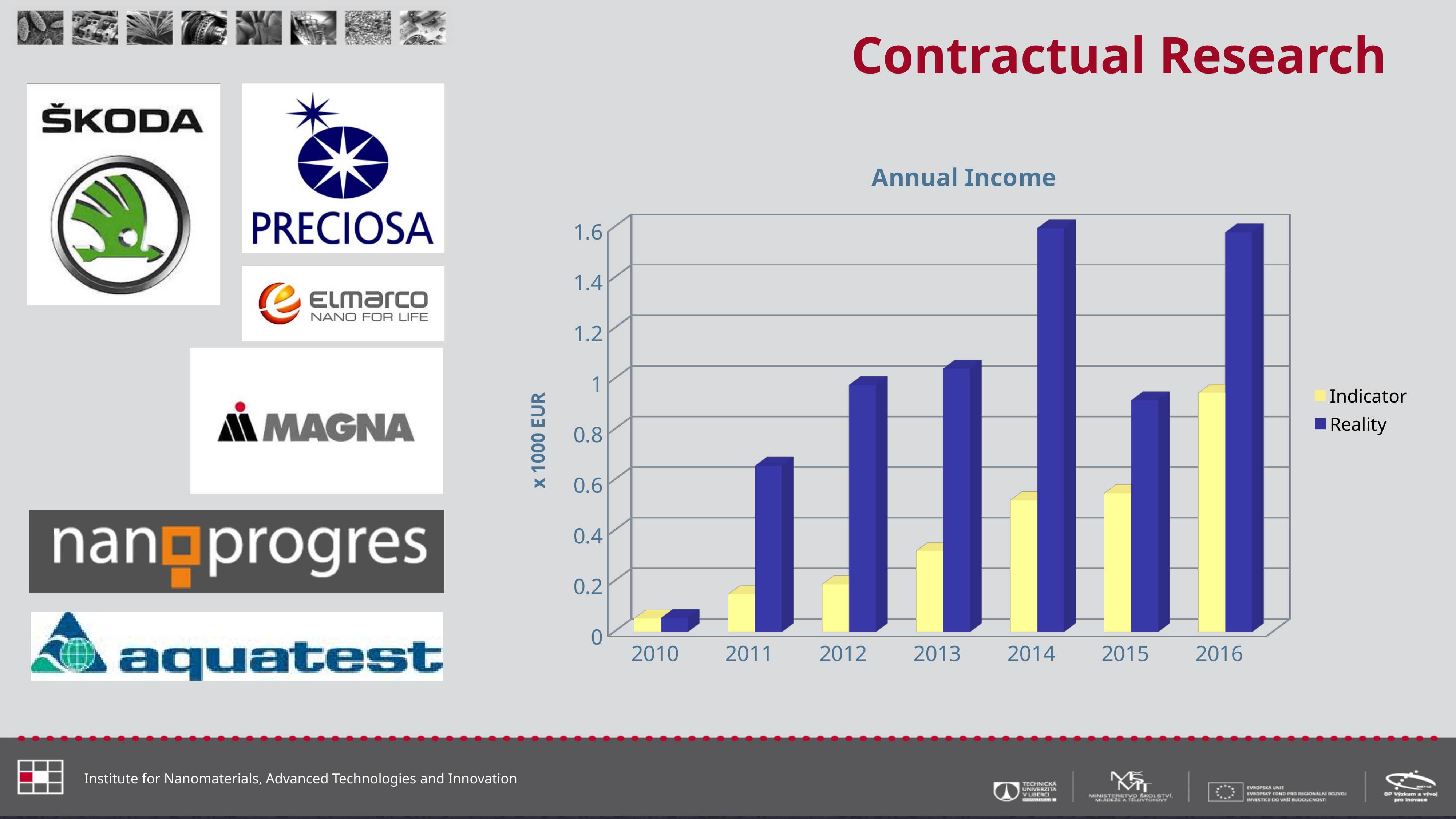
Is the Indicator value for 2013 greater or less than 0.6? less Does the Indicator series rise or fall from 2010 to 2016? rise What is the y-axis label of the Annual Income chart? x 1000 EUR How many series does the legend of the Annual Income chart list? 2 What type of chart is shown under the title "Annual Income"? bar chart How many years are shown on the x axis of the Annual Income chart? 7 In which year is the Reality value lowest in the Annual Income chart? 2010 Is the Reality value for 2011 greater or less than 0.4? greater Which colour represents the Reality series in the Annual Income chart? blue In which year is the Indicator value highest in the Annual Income chart? 2016 Is the Reality value for 2014 greater or less than 1.2? greater In 2013, which is larger: the Indicator value or the Reality value? Reality